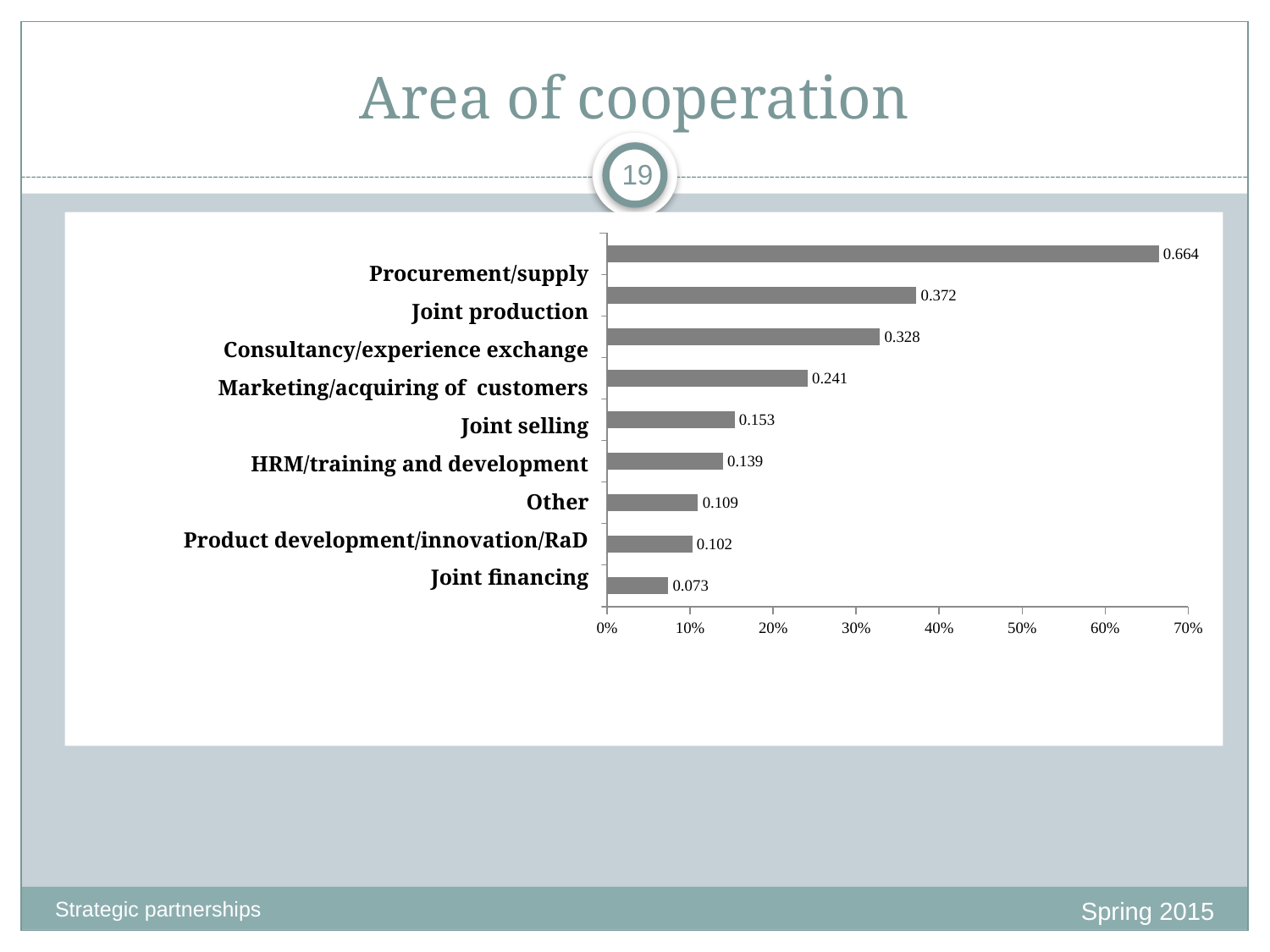
Which area of cooperation has the highest value? Procurement/supply What is the value for Procurement/supply? 0.664 How many categories are shown in the chart? 9 Which is larger, the value for Joint selling or the value for HRM/training and development? Joint selling What is the title of the slide containing the chart? Area of cooperation What is the difference between the values for Procurement/supply and Joint production? 0.292 What is the value for Joint financing? 0.073 What type of chart is shown on the slide? Bar chart Is the value for Consultancy/experience exchange greater or less than 30%? greater What is the value for Joint production? 0.372 What is the value for Marketing/acquiring of customers? 0.241 Which area of cooperation has the lowest value? Joint financing